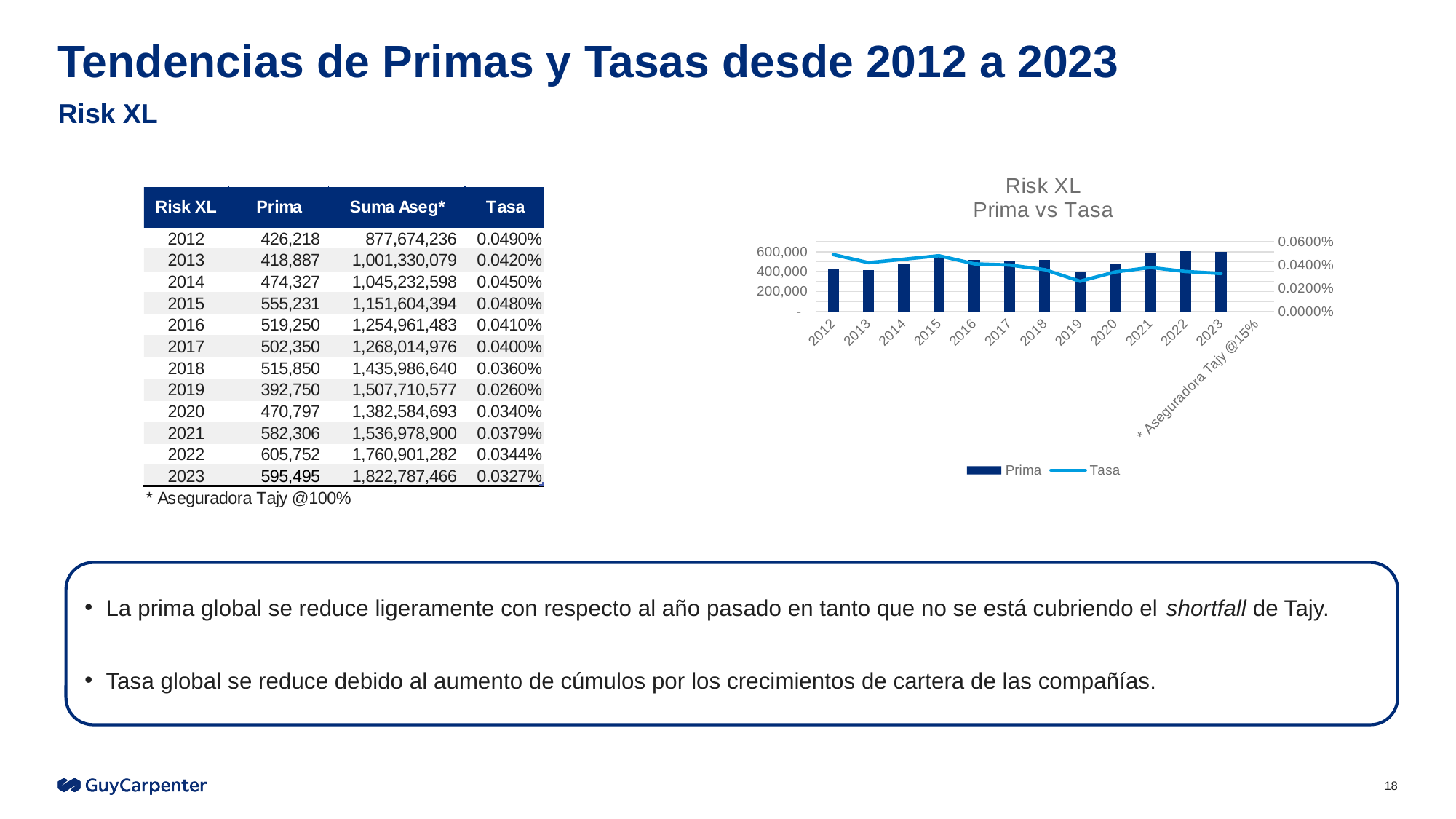
What is the title of the chart? Risk XL Prima vs Tasa Which year has the larger Prima bar, 2015 or 2019? 2015 Which year has the higher Tasa value, 2012 or 2023? 2012 What kind of chart is shown on the slide? A bar chart combined with a line How many years are plotted along the x axis of the chart? 12 Is the Prima value for 2021 greater or less than 400,000? greater Is the Tasa value for 2012 greater or less than 0.0400%? greater Does the Tasa line generally rise or fall from 2012 to 2023? fall Is the Tasa value for 2019 greater or less than 0.0400%? less How many series does the chart legend list? 2 Which year has the lowest Prima bar in the chart? 2019 Which year has the lowest Tasa value on the line in the chart? 2019